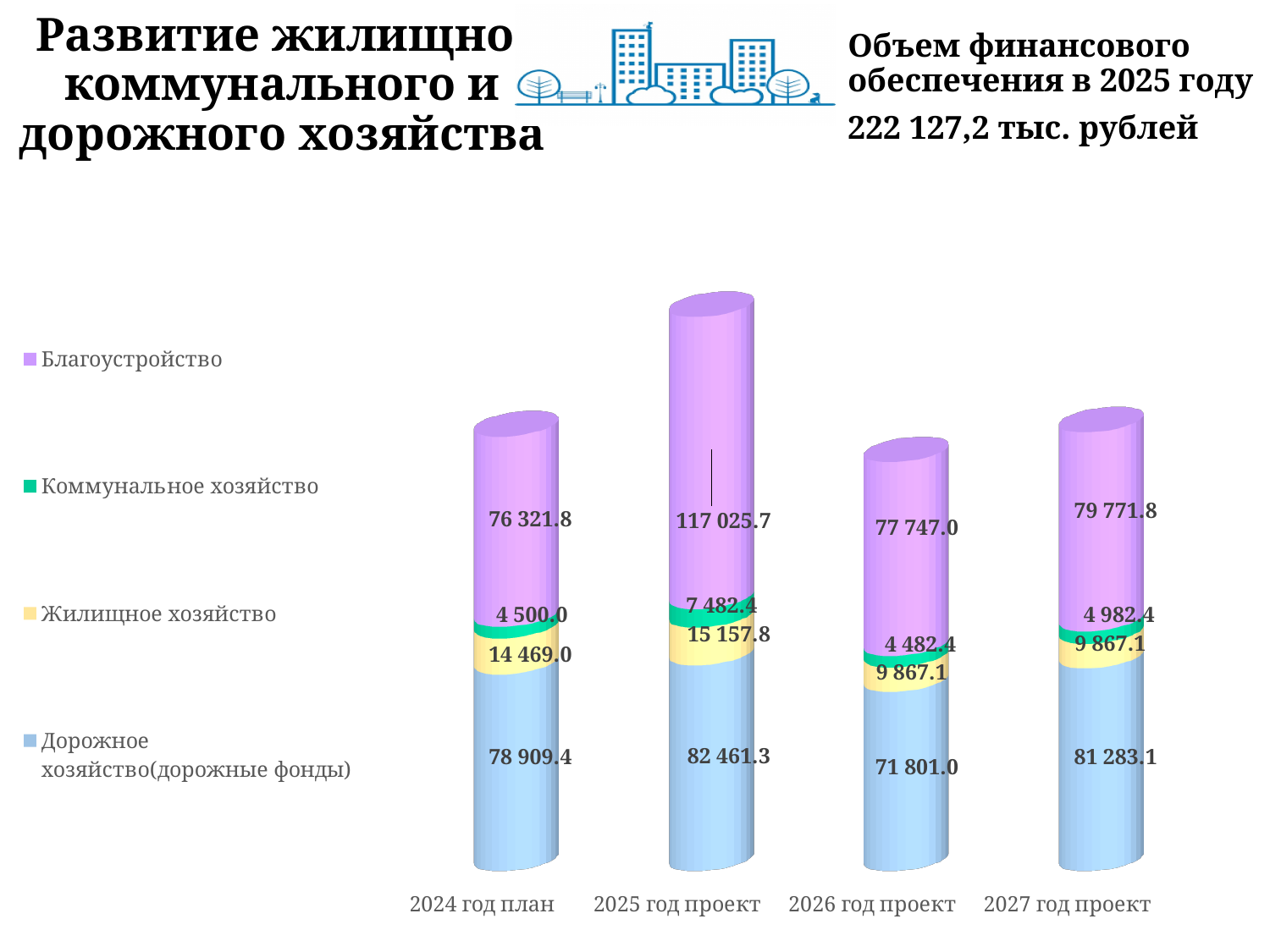
In which year is the value for Благоустройство the highest? 2025 год проект What is the value for Коммунальное хозяйство in 2027 год проект? 4 982.4 How many series does the legend list? 4 What kind of chart is shown on the slide? Stacked bar chart What is the value for Дорожное хозяйство(дорожные фонды) in 2026 год проект? 71 801.0 How many years (categories) are shown on the x axis? 4 In which year is the value for Дорожное хозяйство(дорожные фонды) the lowest? 2026 год проект What is the total of the stacked bar for 2025 год проект? 222 127.2 What is the value for Жилищное хозяйство in 2024 год план? 14 469.0 What is the difference between the Благоустройство values for 2025 год проект and 2024 год план? 40 703.9 Which is larger: Жилищное хозяйство in 2025 год проект or in 2026 год проект? 2025 год проект What is the value for Благоустройство in 2025 год проект? 117 025.7